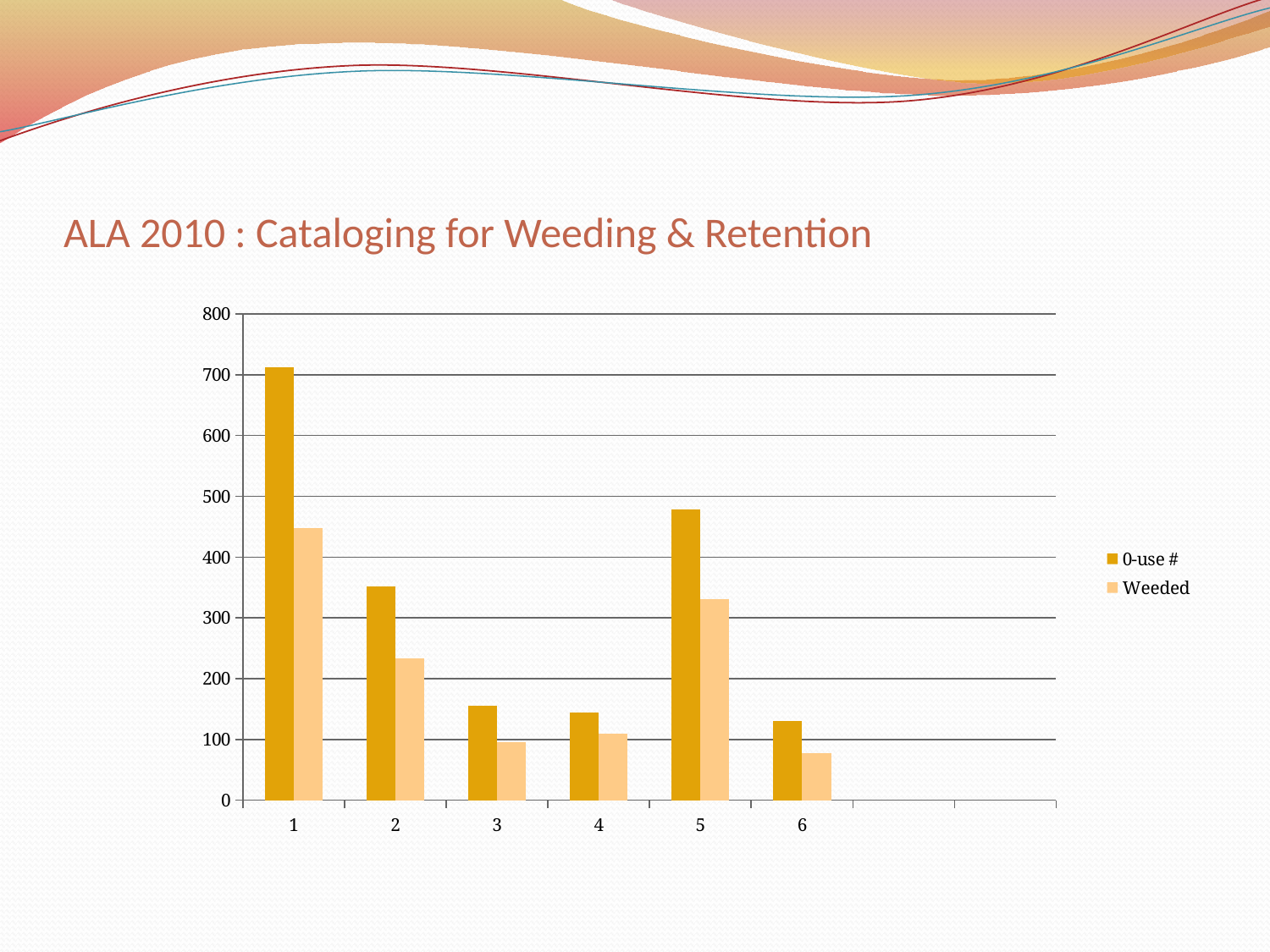
Which category has the highest value for the Weeded series? 1 Is the Weeded value for category 6 greater or less than 100? less Is the 0-use # value for category 5 greater or less than 500? less Which category has the highest value for the 0-use # series? 1 Which is larger, the Weeded value for category 2 or for category 5? category 5 What are the two series named in the legend? 0-use # and Weeded What kind of chart is shown on the slide? bar chart How many series does the legend list? 2 Is the 0-use # value for category 1 greater or less than 600? greater Which is larger, the 0-use # value for category 2 or for category 5? category 5 How many categories are shown on the x axis? 6